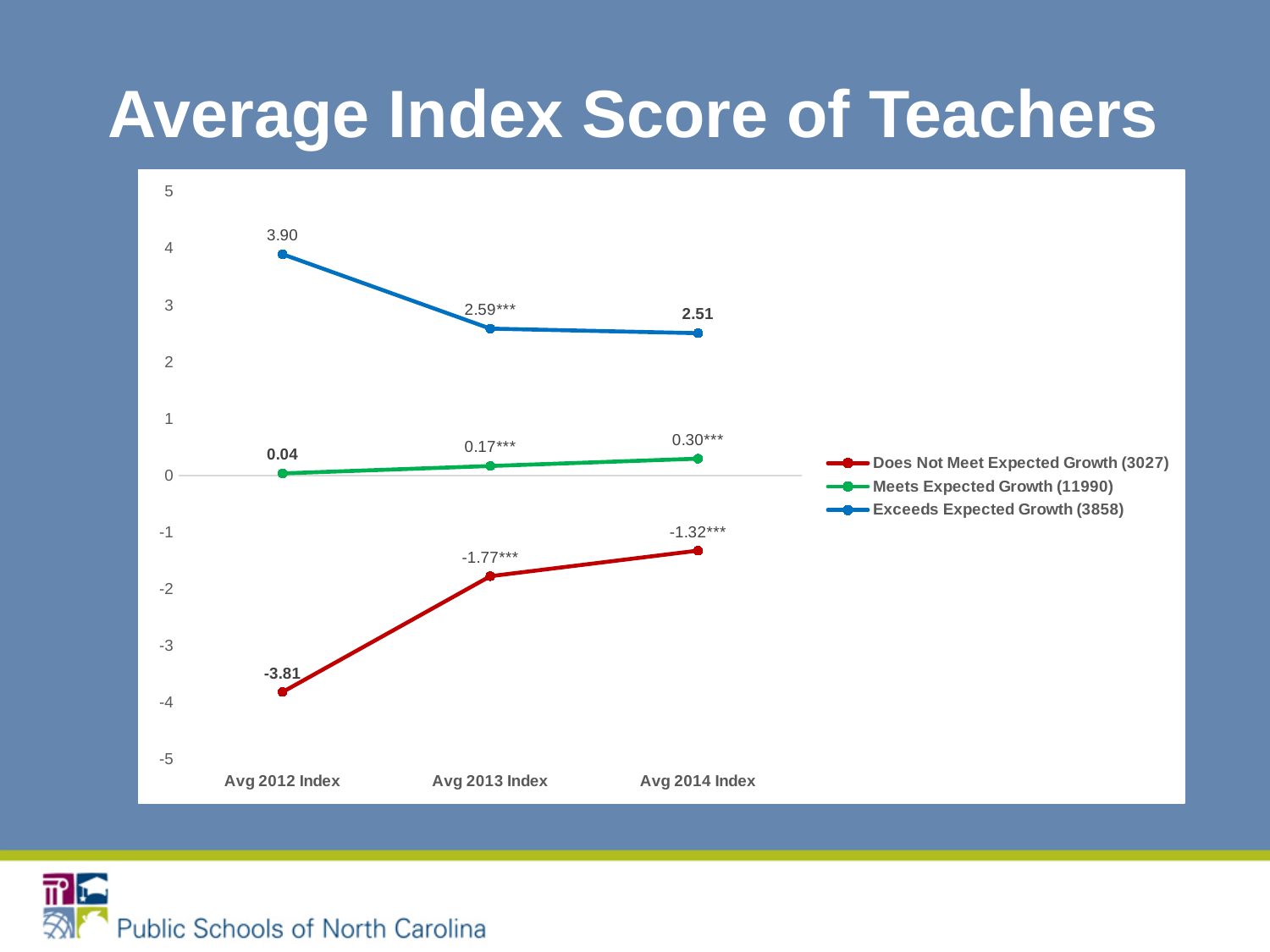
What is the value for Does Not Meet Expected Growth at Avg 2014 Index? -1.32*** Is the Exceeds Expected Growth value at Avg 2013 Index greater or less than 2? greater How many series does the legend list? 3 What is the value for Exceeds Expected Growth at Avg 2012 Index? 3.90 What type of chart is shown on the slide? Line chart Do the values for Does Not Meet Expected Growth rise or fall from Avg 2012 Index to Avg 2014 Index? Rise What is the value for Meets Expected Growth at Avg 2013 Index? 0.17*** How many points are plotted along the x axis for each series? 3 What is the title of the chart? Average Index Score of Teachers What is the difference between the Exceeds Expected Growth values at Avg 2012 Index and Avg 2014 Index? 1.39 Which series has the lowest value at Avg 2012 Index? Does Not Meet Expected Growth (3027) Which series has the highest value at Avg 2014 Index? Exceeds Expected Growth (3858)